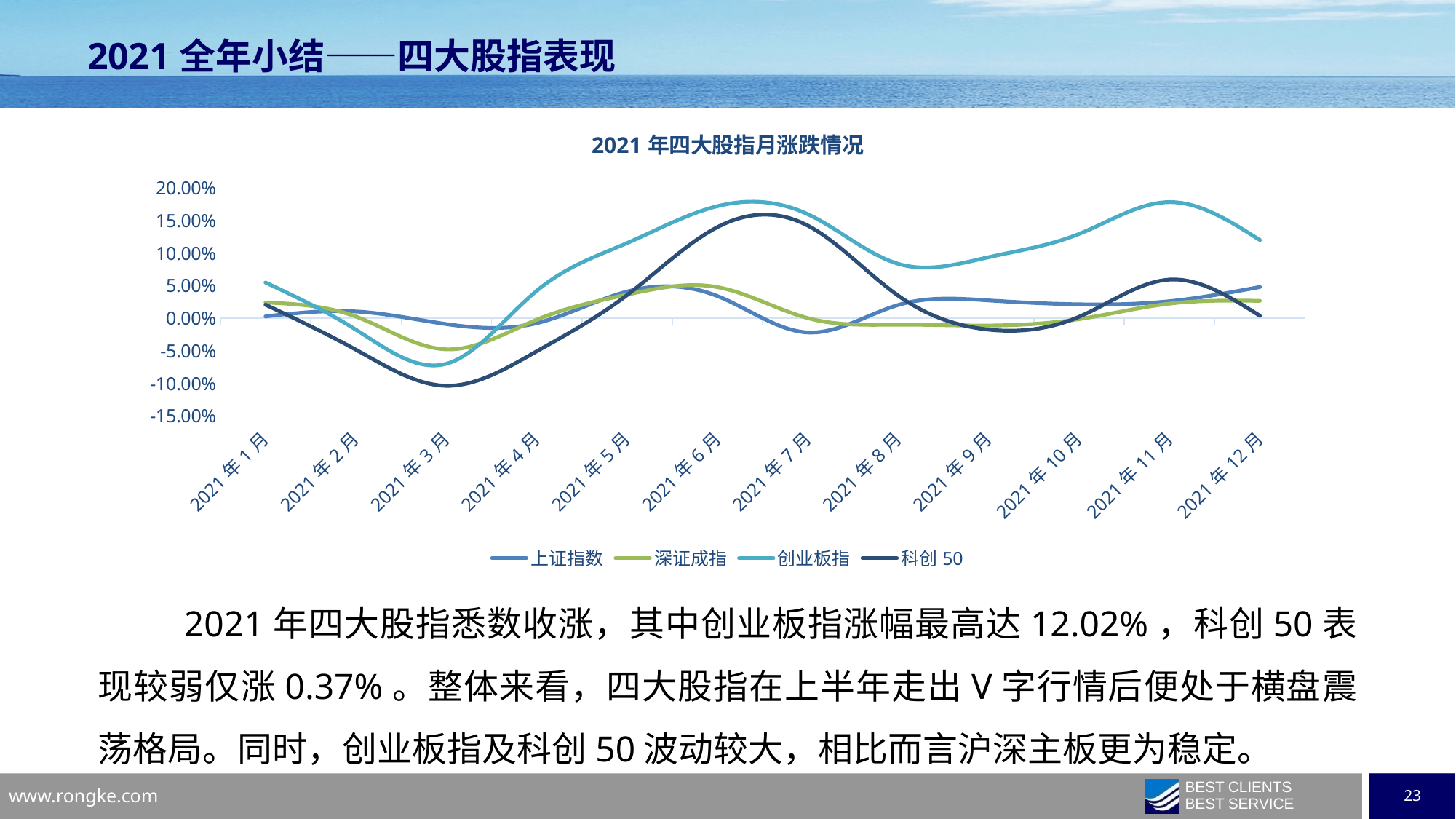
How many months are plotted along the x axis? 12 Is the value for 上证指数 in 2021 年 7 月 greater or less than 0.00%? less Is the value for 科创 50 in 2021 年 7 月 greater or less than 10.00%? greater Is the value for 科创 50 in 2021 年 3 月 greater or less than -5.00%? less How many series does the legend list? 4 Which series is shown in the darkest line in the legend? 科创 50 In which month does 科创 50 reach its lowest value? 2021 年 3 月 What kind of chart is shown on the slide? line chart What is the title of the chart? 2021 年四大股指月涨跌情况 Which series has the highest value in 2021 年 6 月? 创业板指 Does the 创业板指 line rise or fall from 2021 年 3 月 to 2021 年 6 月? rise